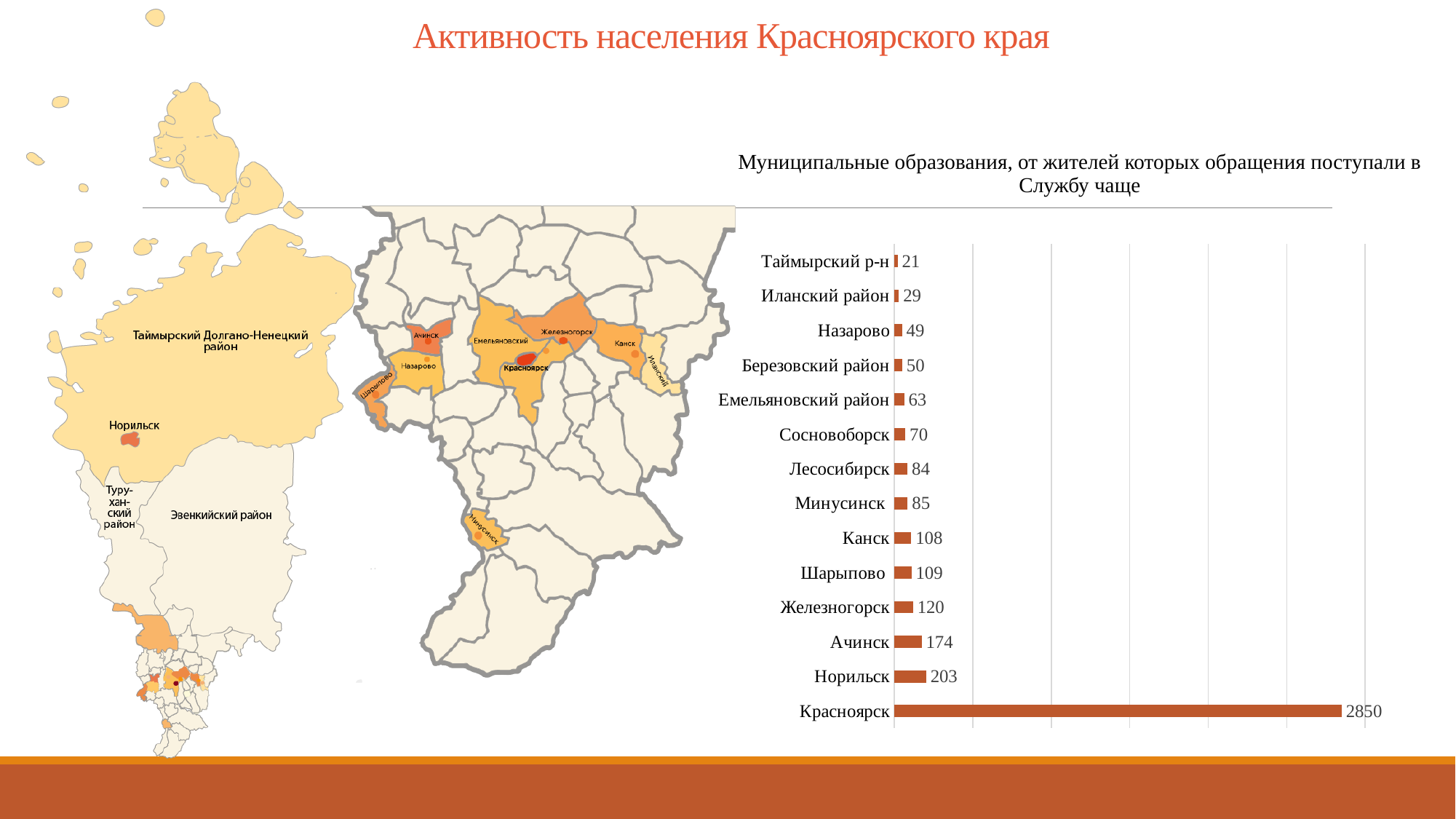
What is the value for Норильск? 203 What is the difference between the values for Железногорск and Канск? 12 What is the title of the bar chart? Муниципальные образования, от жителей которых обращения поступали в Службу чаще How many categories are shown in the bar chart? 14 What is the value for Емельяновский район? 63 What is the value for Красноярск? 2850 Which category has the lowest value? Таймырский р-н What is the difference between the values for Ачинск and Норильск? 29 Which category has the highest value? Красноярск What kind of chart is shown on the right of the slide? Bar chart What is the value for Шарыпово? 109 Which is larger, the value for Лесосибирск or the value for Сосновоборск? Лесосибирск